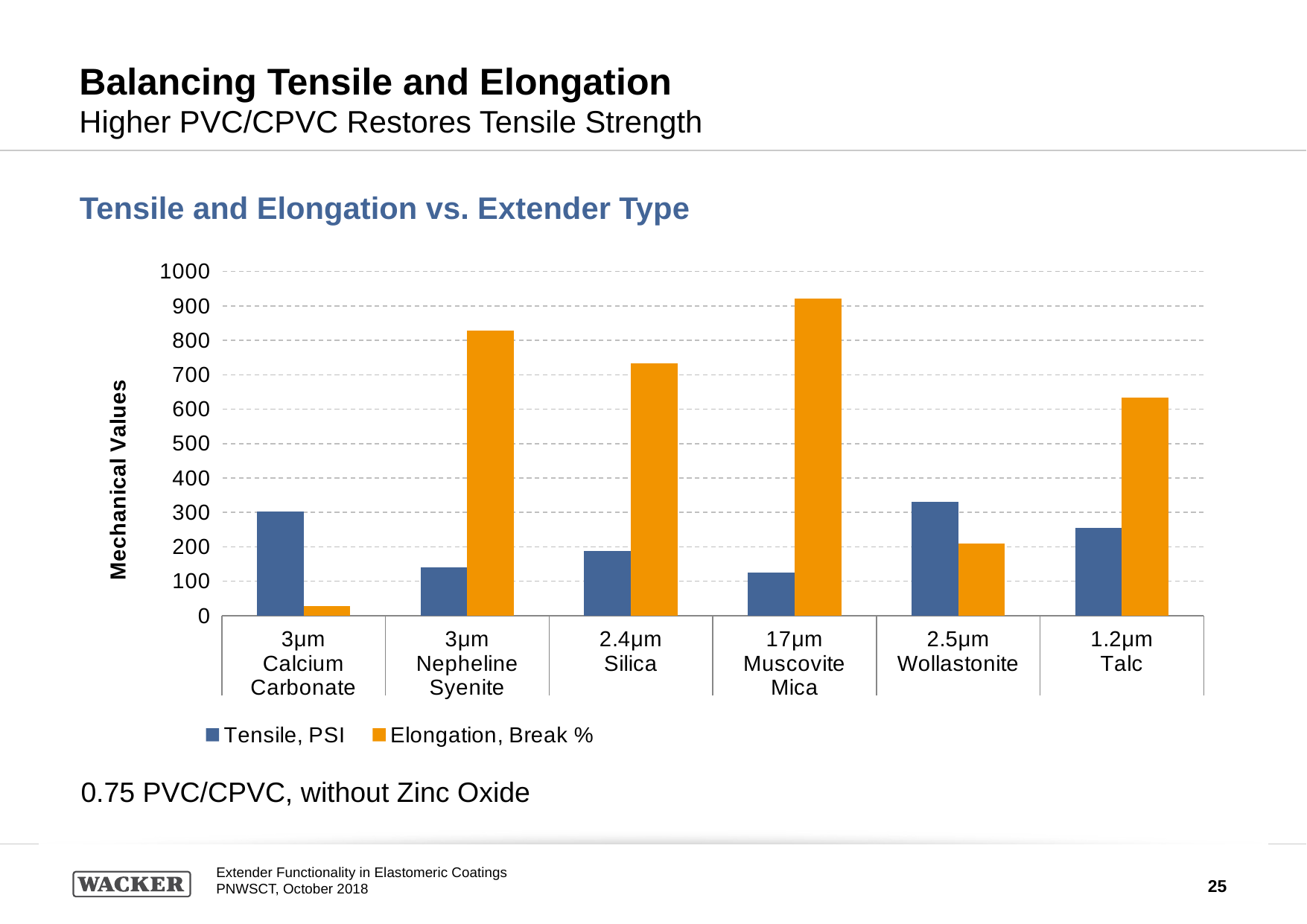
Which extender type has the highest Elongation, Break %? 17µm Muscovite Mica How many extender types are shown on the x axis of the chart? 6 Is the Elongation, Break % for 3µm Nepheline Syenite greater or less than 800? greater Is the Elongation, Break % for 17µm Muscovite Mica greater or less than 900? greater What kind of chart is shown on the slide? bar chart Is the Elongation, Break % for 1.2µm Talc greater or less than 600? greater Which extender type has the lowest Elongation, Break %? 3µm Calcium Carbonate Which is larger, the Elongation, Break % for 3µm Nepheline Syenite or for 2.4µm Silica? 3µm Nepheline Syenite How many series does the legend list? 2 What is the title of the chart? Tensile and Elongation vs. Extender Type Which is larger, the Tensile, PSI for 2.5µm Wollastonite or for 17µm Muscovite Mica? 2.5µm Wollastonite